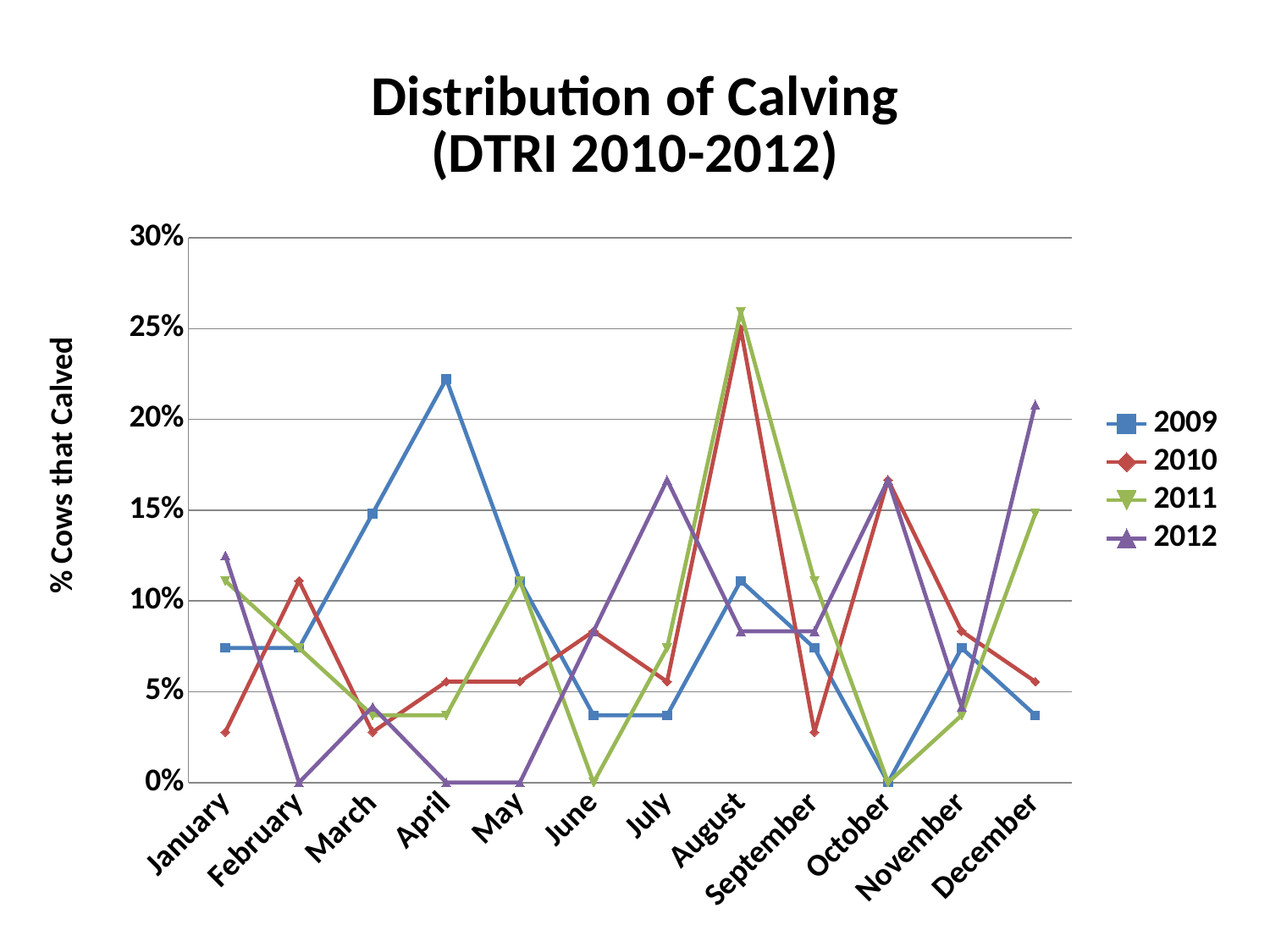
Is the value for 2009 in April greater or less than 20%? greater Is the value for 2010 in January greater or less than 5%? less How many months are shown along the x axis? 12 How many series does the legend list? 4 In which month is the 2009 value highest? April What kind of chart is shown on the slide? line chart What is the value for 2011 in June? 0% What is the title of the y axis? % Cows that Calved Which is larger for 2010: the value in August or the value in October? August What is the value for 2012 in February? 0% What is the value for 2009 in October? 0% In which month is the 2011 value highest? August